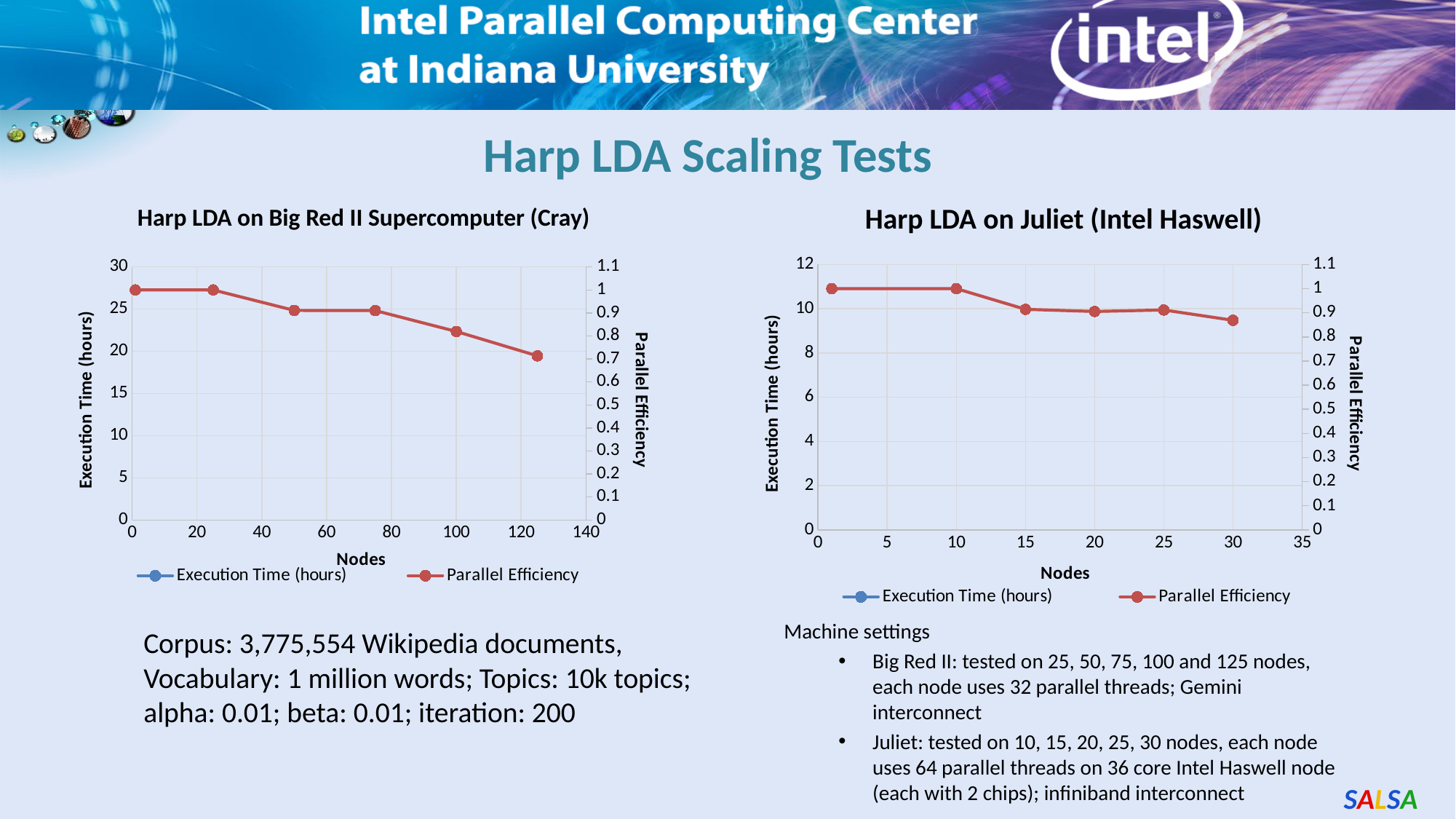
In the 'Harp LDA on Big Red II Supercomputer (Cray)' chart, is Parallel Efficiency higher at 25 nodes or at 125 nodes? 25 nodes In the 'Harp LDA on Juliet (Intel Haswell)' chart, is the Parallel Efficiency at 15 nodes greater or less than 1? less In the 'Harp LDA on Juliet (Intel Haswell)' chart, at which number of nodes is Parallel Efficiency lowest? 30 In the 'Harp LDA on Juliet (Intel Haswell)' chart, does Parallel Efficiency rise or fall as the number of nodes increases? Fall How many series does the legend list in the 'Harp LDA on Juliet (Intel Haswell)' chart? 2 In the 'Harp LDA on Big Red II Supercomputer (Cray)' chart, at which number of nodes is Parallel Efficiency lowest? 125 What kind of chart is 'Harp LDA on Big Red II Supercomputer (Cray)'? Line chart In the 'Harp LDA on Big Red II Supercomputer (Cray)' chart, is the Parallel Efficiency at 50 nodes greater or less than 0.8? greater What is the title of the right-hand vertical axis in the 'Harp LDA on Juliet (Intel Haswell)' chart? Parallel Efficiency In the 'Harp LDA on Juliet (Intel Haswell)' chart, is the Parallel Efficiency at 30 nodes greater or less than 0.8? greater In the 'Harp LDA on Big Red II Supercomputer (Cray)' chart, how many data points are plotted on the Parallel Efficiency line? 6